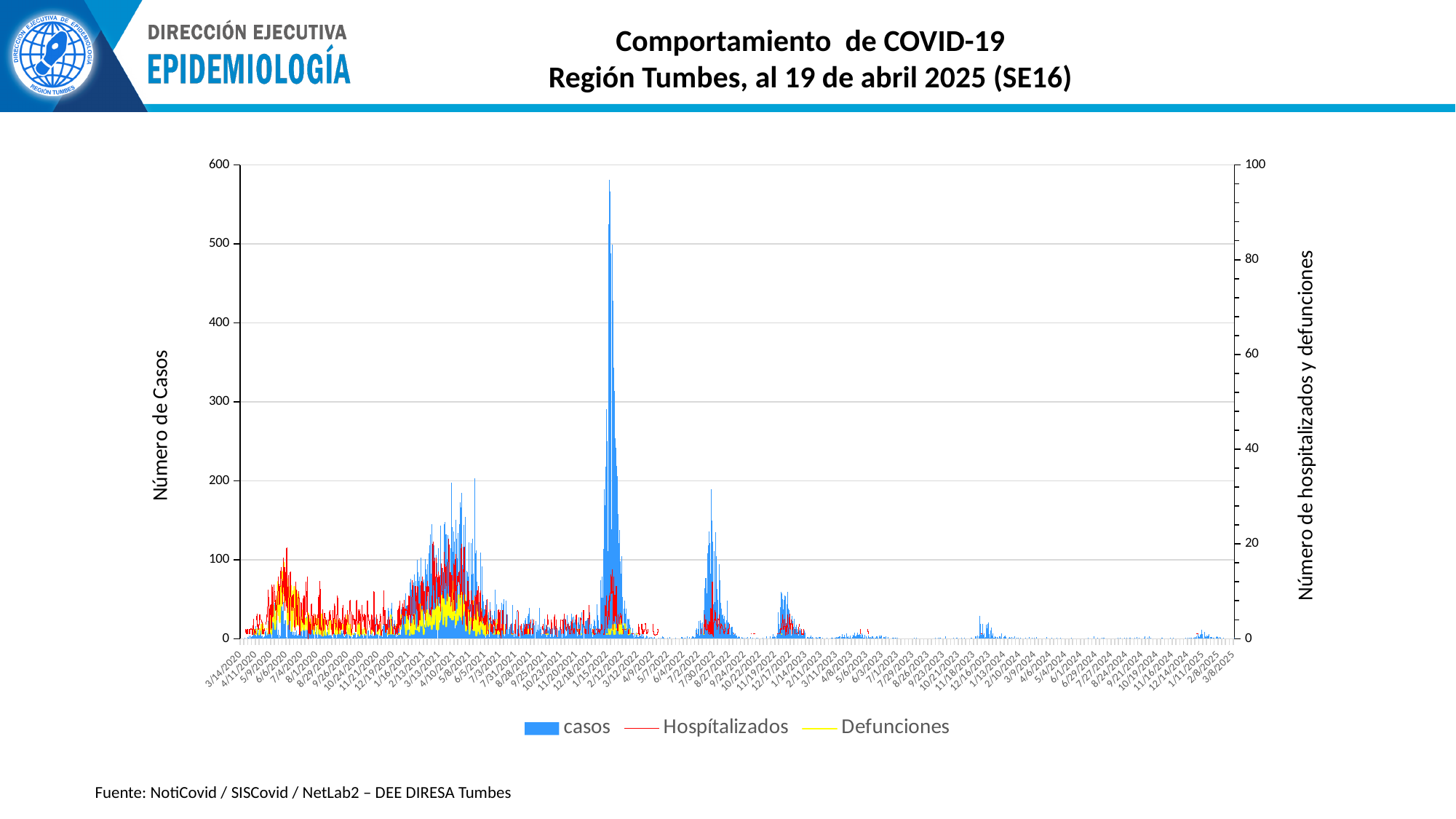
Is the highest casos bar (around January 2022) greater or less than 500 on the left axis? greater What is the label of the right-hand vertical axis? Número de hospitalizados y defunciones Which is larger: casos in 2021 or casos in 2024? 2021 What kind of chart is shown on the slide? bar and line chart Do casos rise or fall from the early 2022 peak through to 2025? fall Which is larger: the casos peak in early 2022 or the casos peak in mid 2022? early 2022 How many series does the legend list? 3 What are the three series listed in the legend? casos, Hospítalizados, Defunciones Is the casos peak around 7/30/2022 greater or less than 200 on the left axis? less In which period does the casos series reach its highest peak? January 2022 Is the casos peak around 6/5/2021 greater or less than 300 on the left axis? less